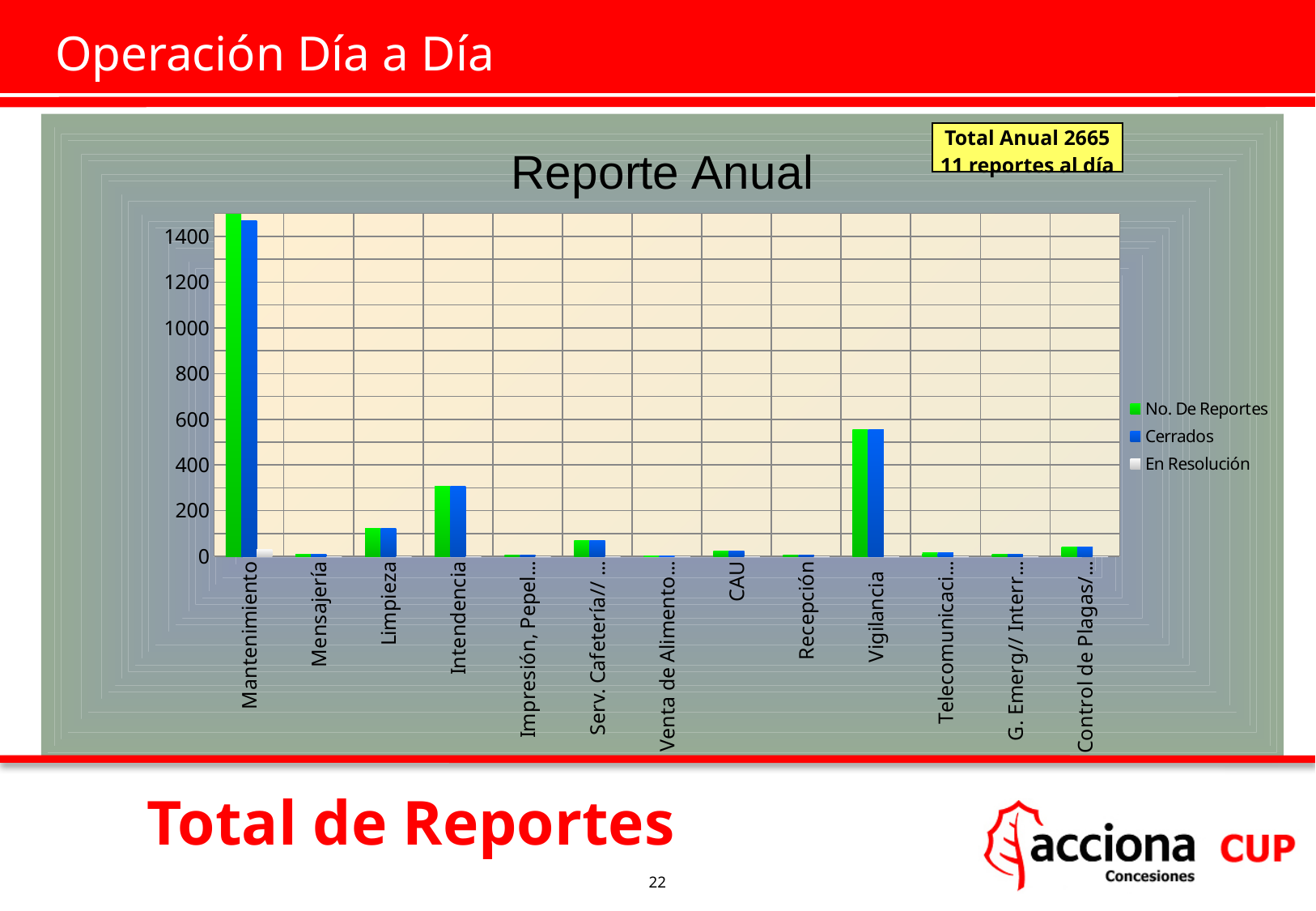
Which has more reports (No. De Reportes): Vigilancia or Intendencia? Vigilancia How many series does the chart legend list? 3 Which category has the highest number of reports (No. De Reportes)? Mantenimiento Is the No. De Reportes value for Vigilancia greater or less than 600? less Is the No. De Reportes value for Limpieza greater or less than 200? less What is the title of the chart? Reporte Anual What annual total is stated in the box at the top right of the chart? Total Anual 2665 How many categories are shown along the x axis of the chart? 13 Is the No. De Reportes value for Intendencia greater or less than 200? greater What kind of chart is shown on the slide? bar chart